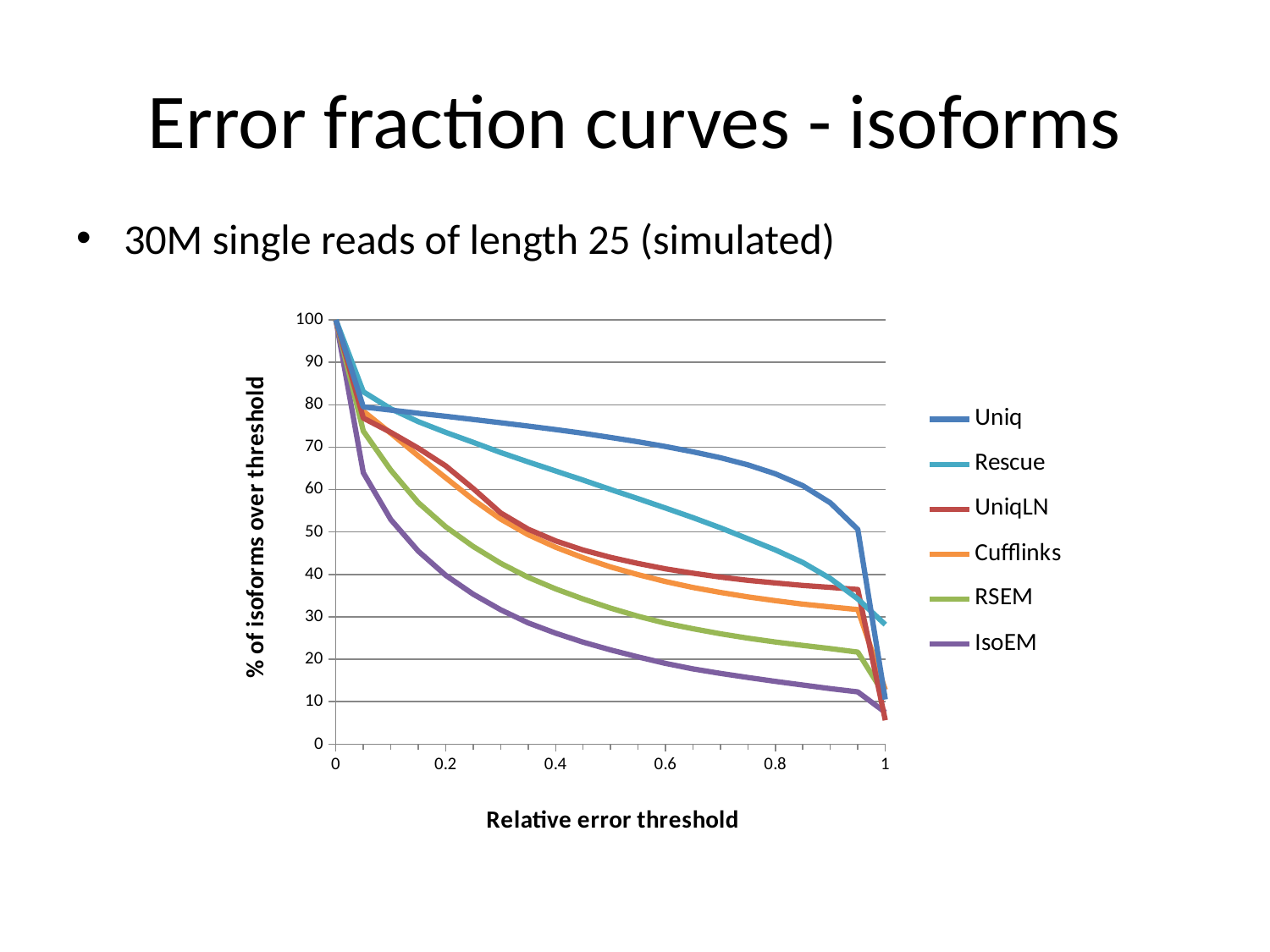
Is the value for IsoEM at a relative error threshold of 0.4 greater or less than 30? less What kind of chart is shown on the slide? line chart Do the values of the IsoEM series rise or fall as the relative error threshold increases? fall Is the value for Uniq at a relative error threshold of 0.4 greater or less than 70? greater What is the label of the x axis? Relative error threshold Which series has the lowest value at a relative error threshold of 0.6? IsoEM Is the value for Rescue at a relative error threshold of 0.6 greater or less than 50? greater What is the label of the y axis? % of isoforms over threshold What is the value of the Uniq series at a relative error threshold of 0? 100 At a relative error threshold of 0.6, which series has the higher value, Uniq or IsoEM? Uniq How many series does the legend list? 6